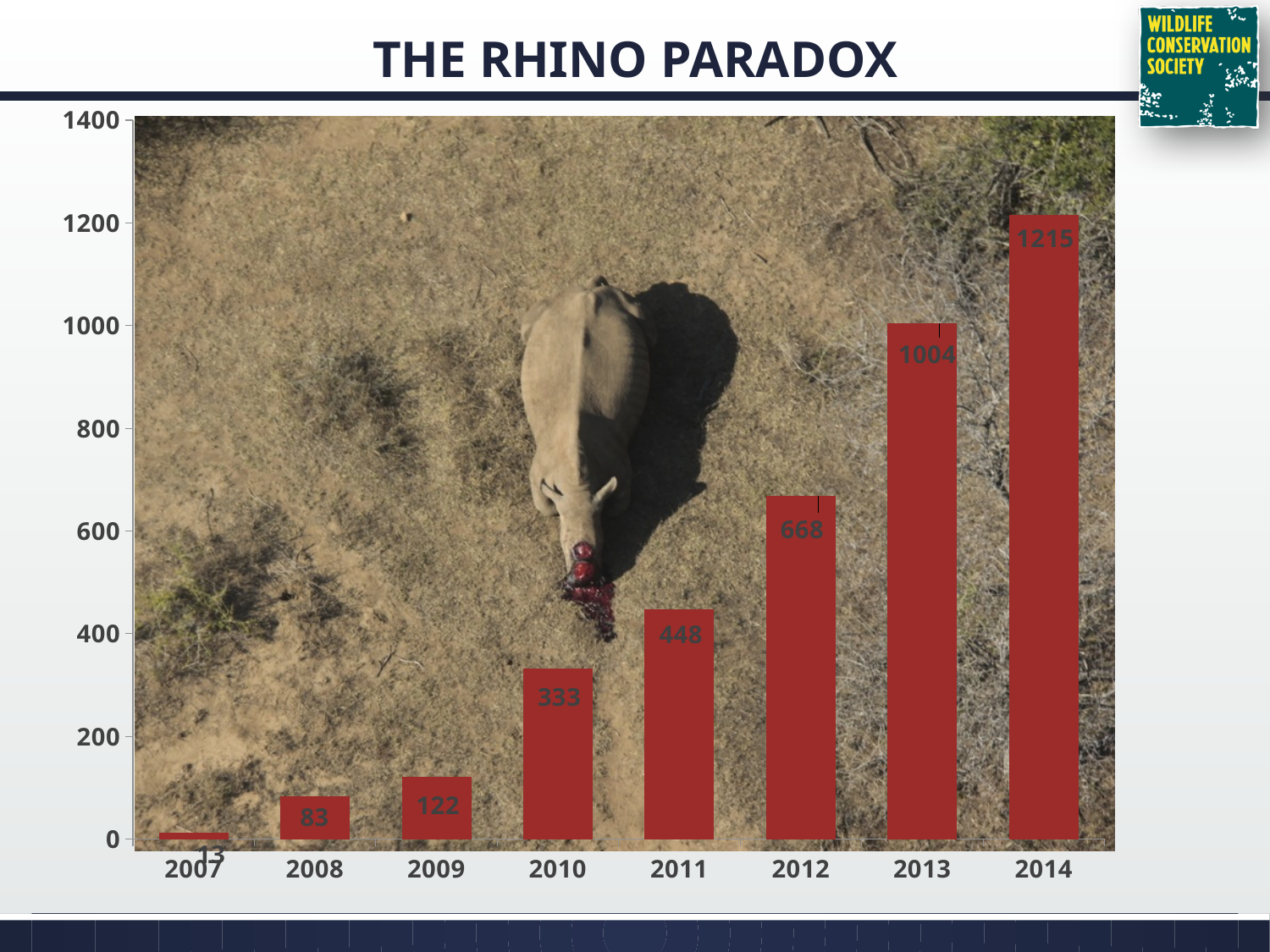
What is the value for 2010? 333 What is the value for 2014? 1215 How many years are shown on the x axis? 8 What is the difference between the values for 2014 and 2013? 211 What is the value for 2012? 668 What kind of chart is shown on the slide? Bar chart What is the difference between the values for 2011 and 2009? 326 Which year has the lowest value? 2007 Which is larger, the value for 2012 or the value for 2011? 2012 What is the value for 2008? 83 Do the values rise or fall from 2007 to 2014? Rise Which year has the highest value? 2014